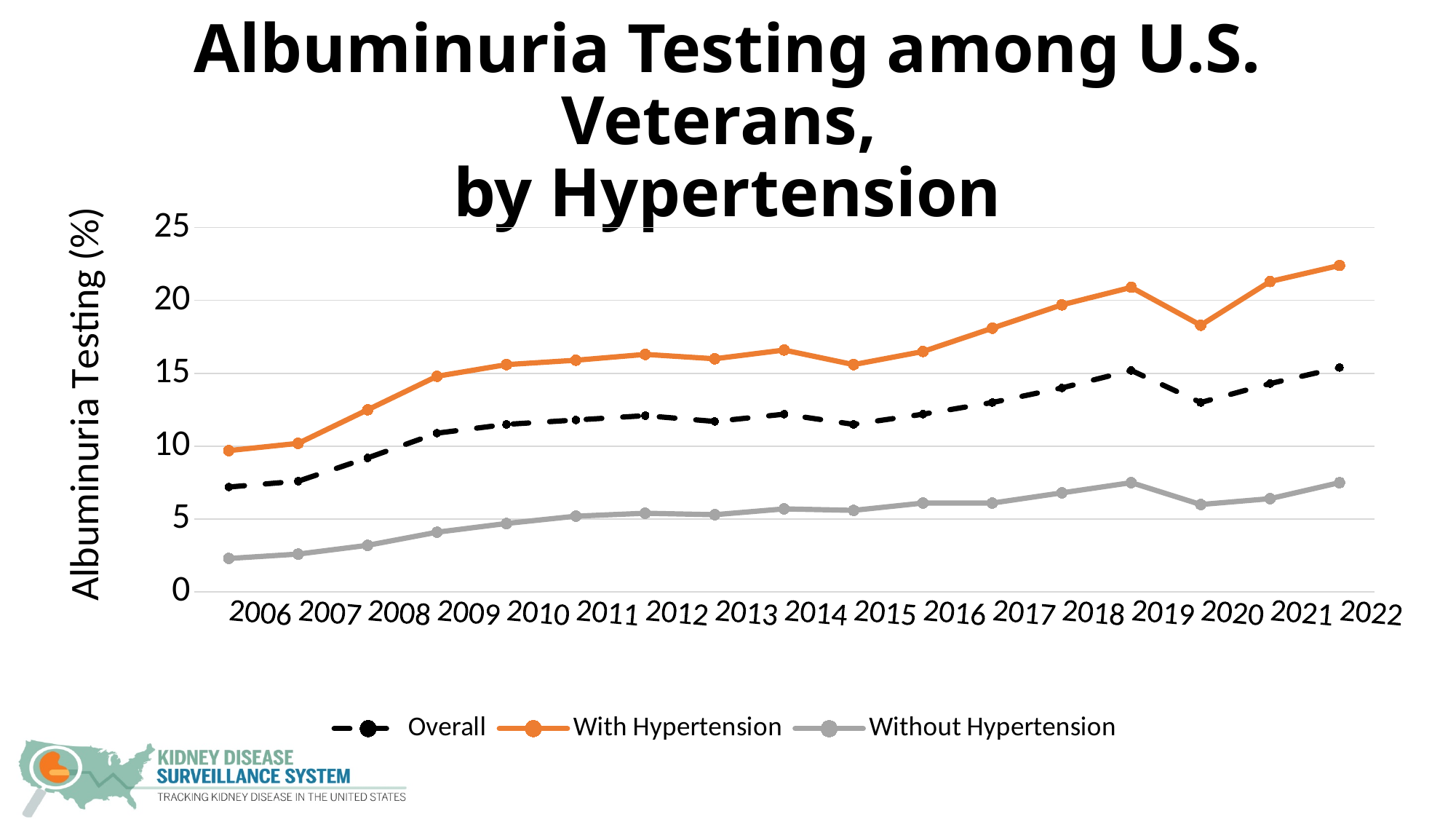
Is the value for Overall in 2012 greater or less than 10? greater Is the value for Without Hypertension in 2006 greater or less than 5? less What is the label on the y axis? Albuminuria Testing (%) For With Hypertension, which year has the larger value, 2019 or 2020? 2019 How many series does the legend list? 3 How many years are plotted along the x axis? 17 What colour is the With Hypertension line? orange Which series has the lowest value in 2006? Without Hypertension Does the Overall series rise or fall from 2006 to 2022? rise What kind of chart is shown on the slide? line chart Which series has the highest value in 2022? With Hypertension Is the value for With Hypertension in 2022 greater or less than 20? greater